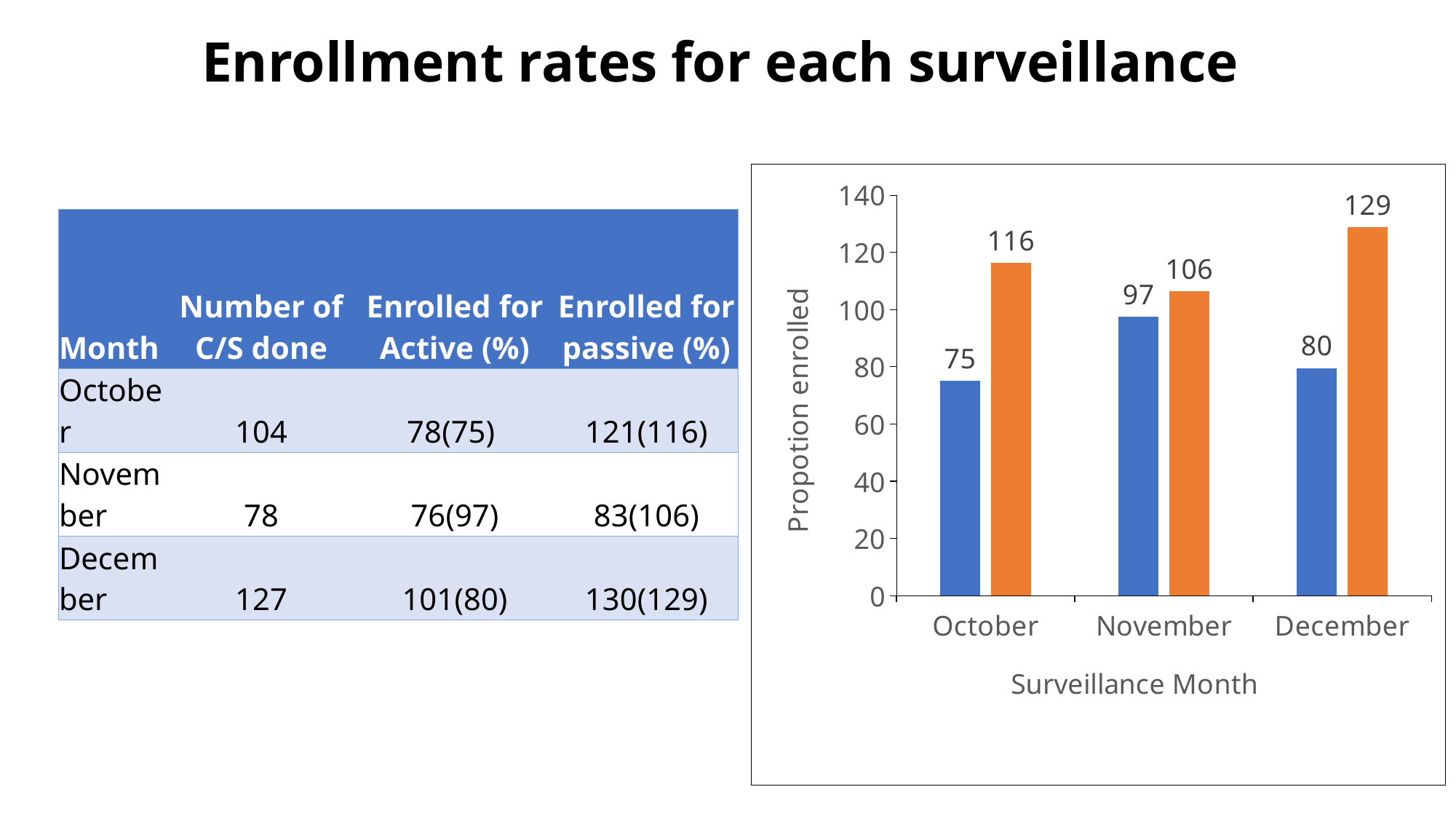
What kind of chart is shown on the slide? Bar chart What is the value of the orange bar for December? 129 What is the difference between the orange bar and the blue bar for December? 49 Which month has the highest orange bar? December What is the value of the orange bar for November? 106 Which month has the lowest blue bar? October What is the value of the blue bar for October? 75 For November, which is larger, the blue bar or the orange bar? The orange bar How many months are shown on the x axis of the chart? 3 Is the value of the orange bar for October greater or less than 100? greater Which month has the highest blue bar? November What is the difference between the orange bar and the blue bar for October? 41